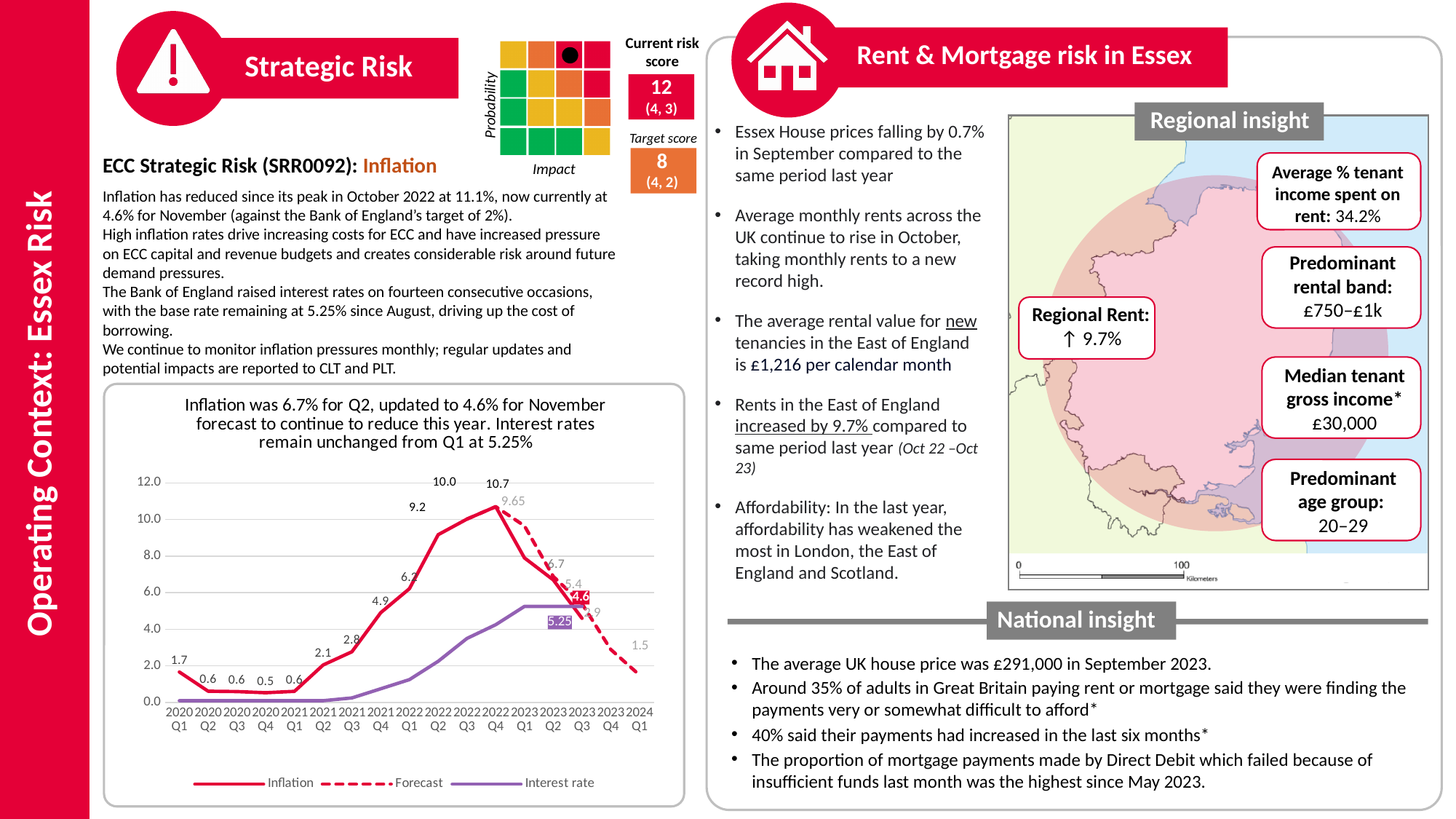
What are the three series named in the chart legend? Inflation, Forecast, Interest rate How many quarters are shown along the x axis of the chart? 17 What is the inflation value for 2020 Q1? 1.7 What is the inflation value for 2021 Q4? 4.9 How many series does the chart legend list? 3 What is the forecast value shown for 2024 Q1? 1.5 In which quarter does the Inflation series reach its highest value? 2022 Q4 Which is larger, the inflation value for 2021 Q2 or for 2021 Q3? 2021 Q3 What is the lowest labelled inflation value on the chart? 0.5 What is the difference between the peak inflation value of 10.7 and the 2020 Q1 value of 1.7? 9.0 What kind of chart is shown on the slide? line chart What is the inflation value for 2022 Q2? 9.2